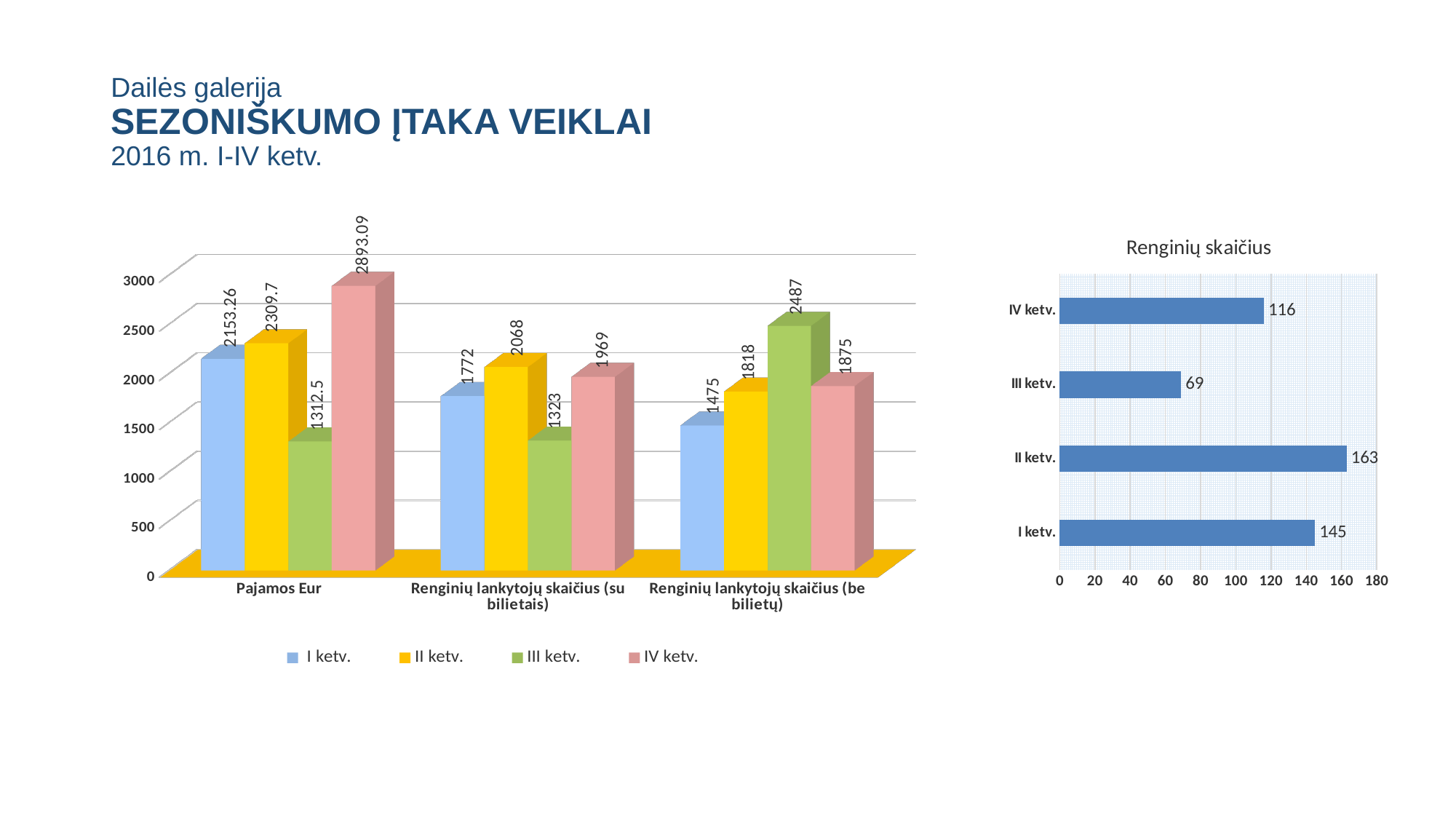
In the Renginių skaičius chart, which quarter has the lowest value? III ketv. In the left chart, what is the difference between the II ketv. and I ketv. values in the Renginių lankytojų skaičius (su bilietais) category? 296 In the left chart, what is the value for IV ketv. in the Pajamos Eur category? 2893.09 In the Renginių skaičius chart, what is the difference between I ketv. and IV ketv.? 29 In the left chart, which series has the lowest value in the Pajamos Eur category? III ketv. In the left chart, which series has the highest value in the Renginių lankytojų skaičius (su bilietais) category? II ketv. In the Renginių skaičius chart, what is the value for II ketv.? 163 How many categories are shown on the x axis of the left chart? 3 What kind of chart is the Renginių skaičius chart? Bar chart In the left chart, which is larger in the Renginių lankytojų skaičius (be bilietų) category: II ketv. or IV ketv.? IV ketv. How many series does the legend of the left chart list? 4 In the left chart, what is the value for III ketv. in the Renginių lankytojų skaičius (be bilietų) category? 2487